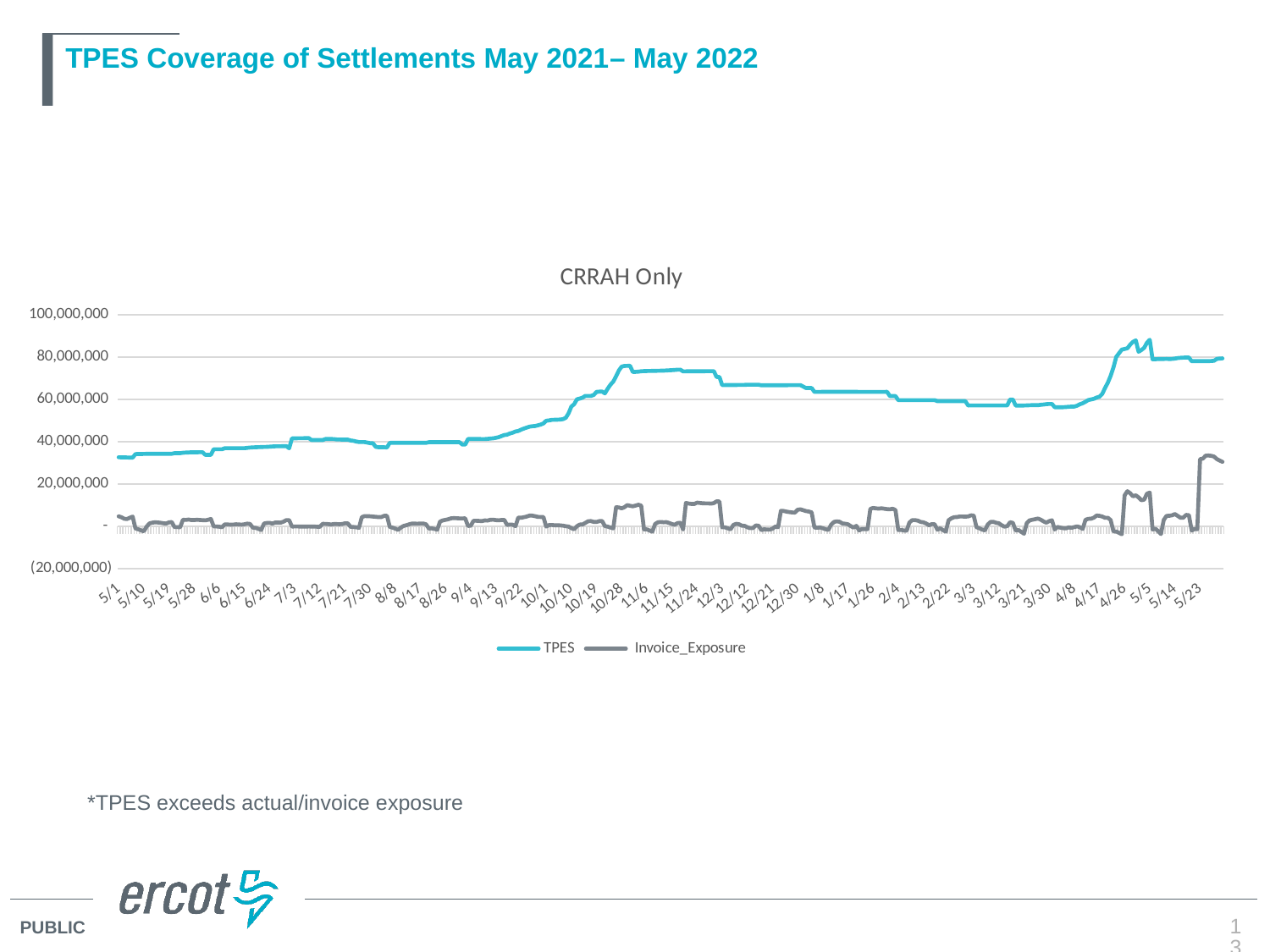
At 11/6, which series has the larger value, TPES or Invoice_Exposure? TPES Is the TPES value at 5/5 greater or less than 80,000,000? greater Is the TPES value at 5/1 greater or less than 40,000,000? less Is the TPES value at 5/1 greater or less than 20,000,000? greater How many series does the legend list? 2 What is the title shown above the chart? CRRAH Only What are the two series named in the legend? TPES and Invoice_Exposure What kind of chart is shown on the slide? Line chart Does the TPES line overall rise or fall from 5/1 to 5/23? rise